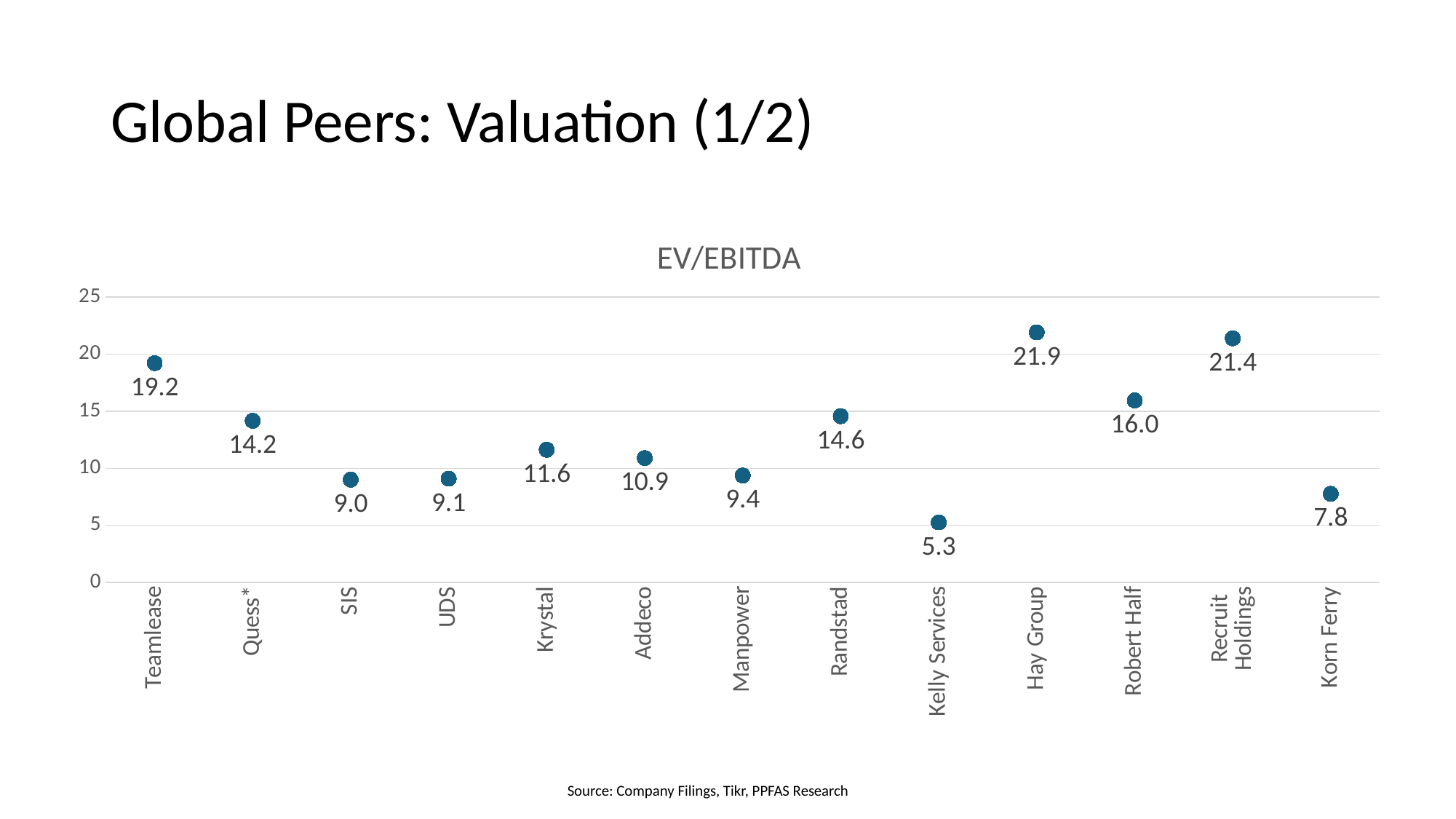
What is the EV/EBITDA value for Teamlease? 19.2 Is the EV/EBITDA value for Korn Ferry greater or less than 10? less Which has a higher EV/EBITDA, Quess* or Randstad? Randstad What kind of chart is shown on the slide? Scatter chart What is the EV/EBITDA value for Kelly Services? 5.3 Which company has the highest EV/EBITDA? Hay Group What is the difference between the EV/EBITDA of Krystal and Addeco? 0.7 How many companies are plotted on the chart? 13 Which company has the lowest EV/EBITDA? Kelly Services What is the difference between the EV/EBITDA of Hay Group and Robert Half? 5.9 What is the EV/EBITDA value for Recruit Holdings? 21.4 What is the title of the chart? EV/EBITDA